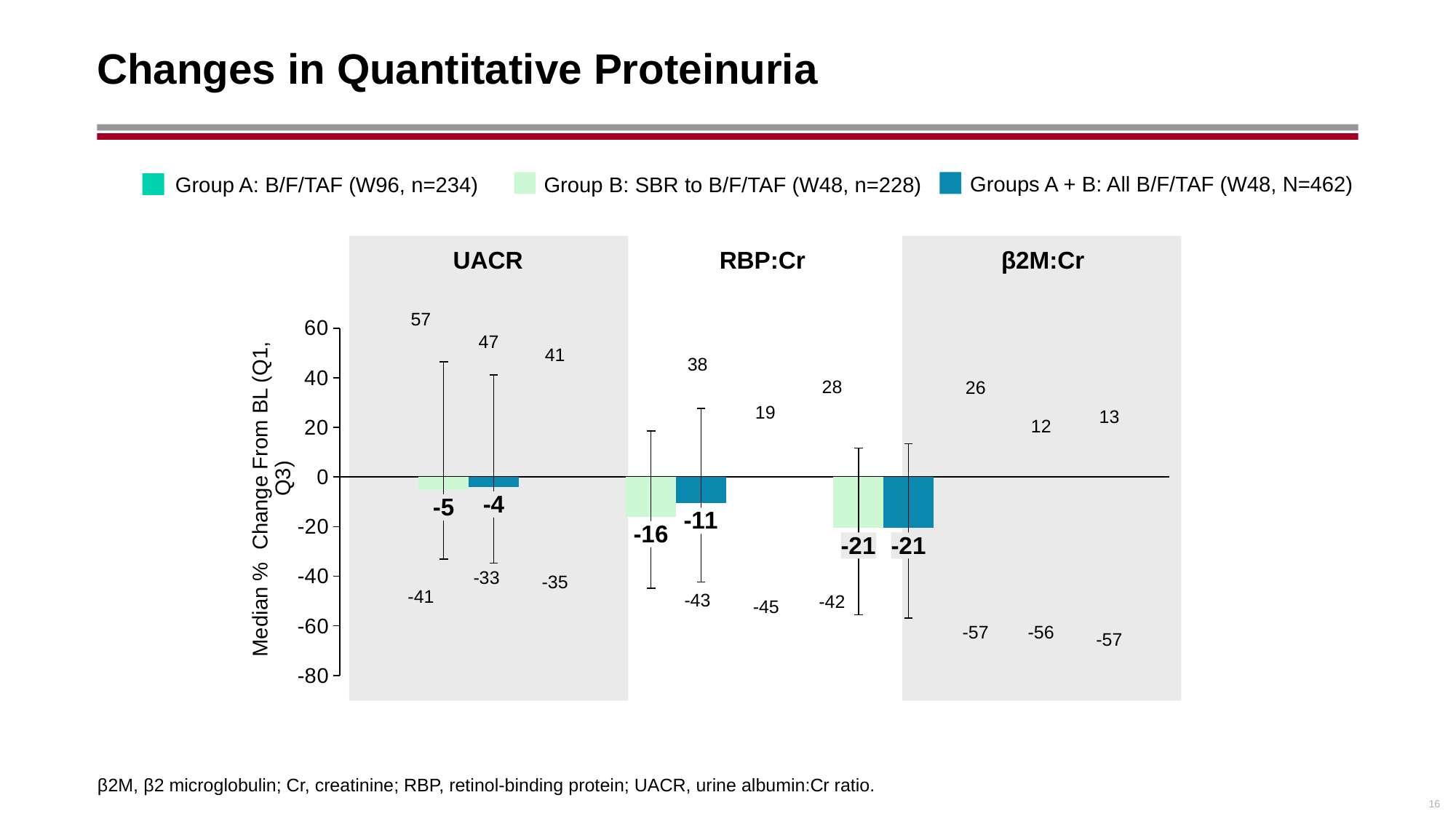
What is the median % change from baseline in β2M:Cr for Group B: SBR to B/F/TAF? -21 For Group B: SBR to B/F/TAF, which shows a larger decrease from baseline, RBP:Cr or β2M:Cr? β2M:Cr What is the median % change from baseline in UACR for Group B: SBR to B/F/TAF? -5 What is the median % change from baseline in UACR for Groups A + B: All B/F/TAF? -4 What kind of chart is shown on the slide? bar chart What is the median % change from baseline in RBP:Cr for Groups A + B: All B/F/TAF? -11 What is the difference between the Group B and Groups A + B median % change values for RBP:Cr? 5 How many series does the legend list? 3 What is the title of the slide? Changes in Quantitative Proteinuria How many biomarker categories are shown on the x axis? 3 What is the label of the y axis? Median % Change From BL (Q1, Q3) Which biomarker has the lowest median % change from baseline for Group B: SBR to B/F/TAF? β2M:Cr